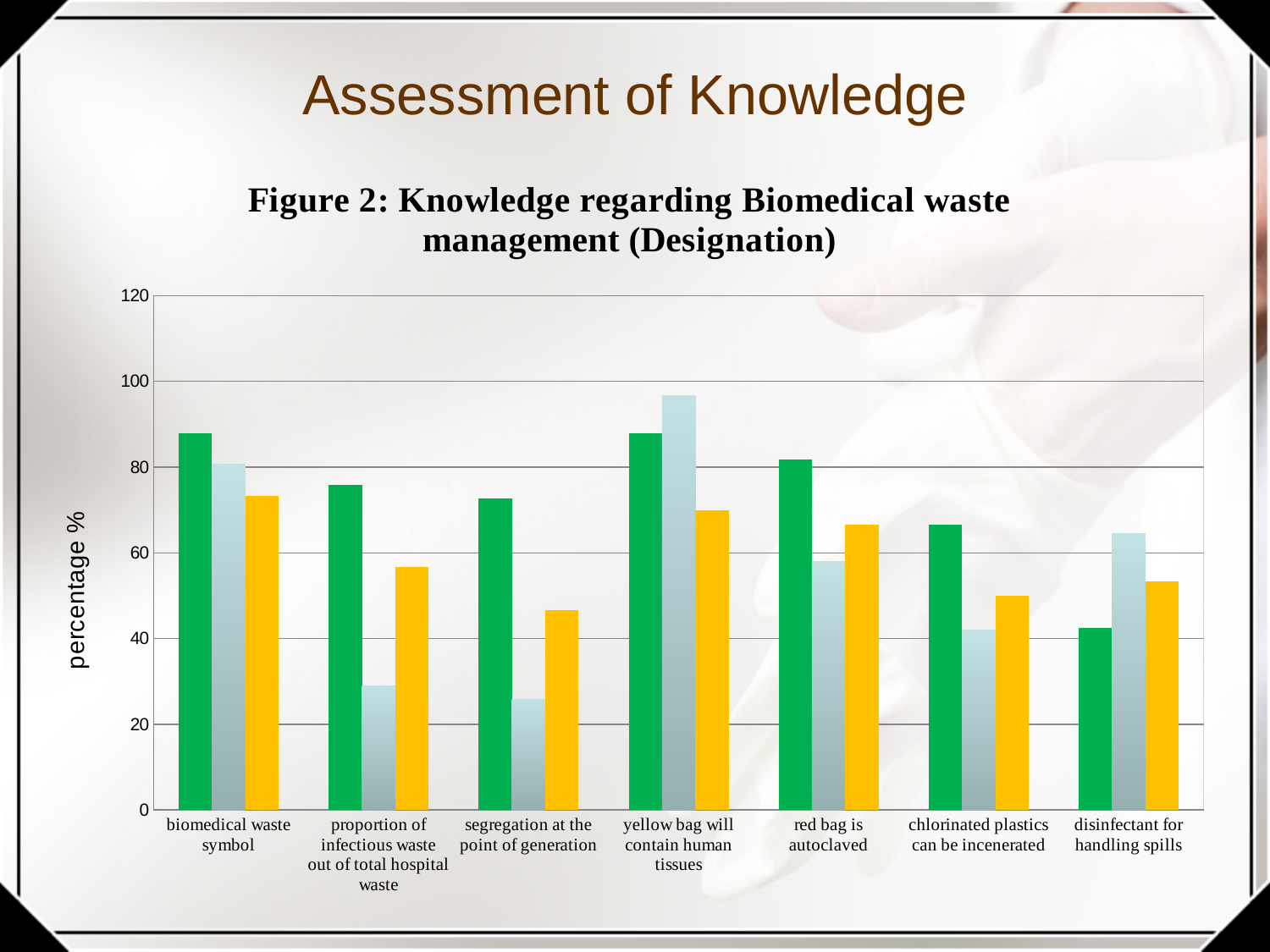
What is the title of the chart? Figure 2: Knowledge regarding Biomedical waste management (Designation) Is the light blue bar for "segregation at the point of generation" greater or less than 40? less Is the green bar for "disinfectant for handling spills" greater or less than 60? less What is the label on the y axis of the chart? percentage % How many bars are plotted for each category in the chart? 3 Is the green bar for "biomedical waste symbol" greater or less than 80? greater Among the green bars, which category has the lowest value? disinfectant for handling spills What kind of chart is shown on the slide? bar chart For "yellow bag will contain human tissues", which bar is taller, the green bar or the light blue bar? light blue Among the light blue bars, which category has the highest value? yellow bag will contain human tissues How many categories are shown along the x axis of the chart? 7